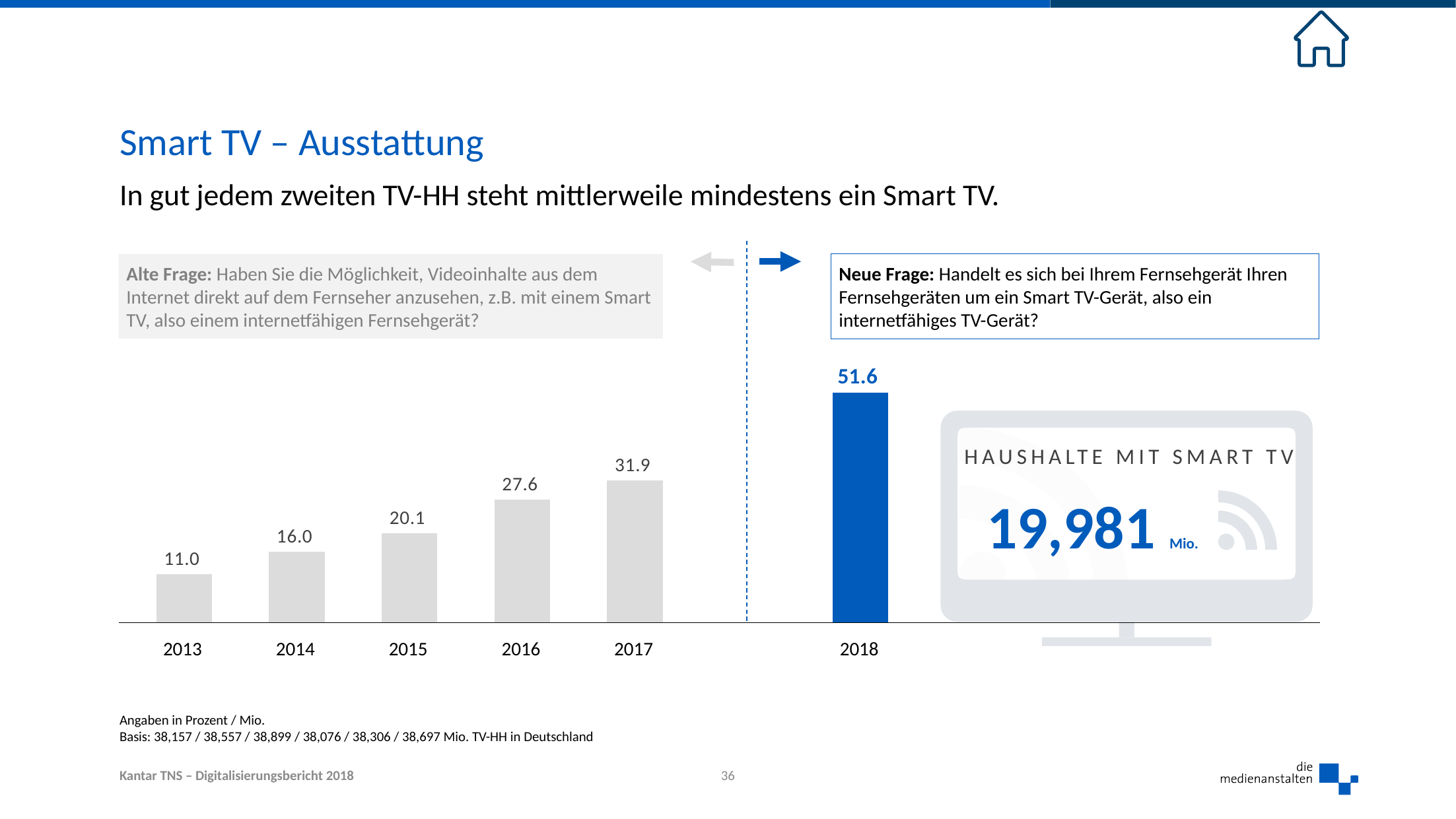
What is the value shown for 2013? 11.0 What kind of chart is shown on the slide? bar chart What is the value shown for 2016? 27.6 Do the values rise or fall from 2013 to 2018? rise What is the value shown for 2018? 51.6 What is the difference between the values for 2018 and 2017? 19.7 How many years are shown on the x axis? 6 What is the difference between the values for 2017 and 2016? 4.3 Which is larger, the value for 2015 or the value for 2014? 2015 Which year has the lowest value? 2013 Which bar is coloured blue rather than grey? 2018 Which year has the highest value? 2018